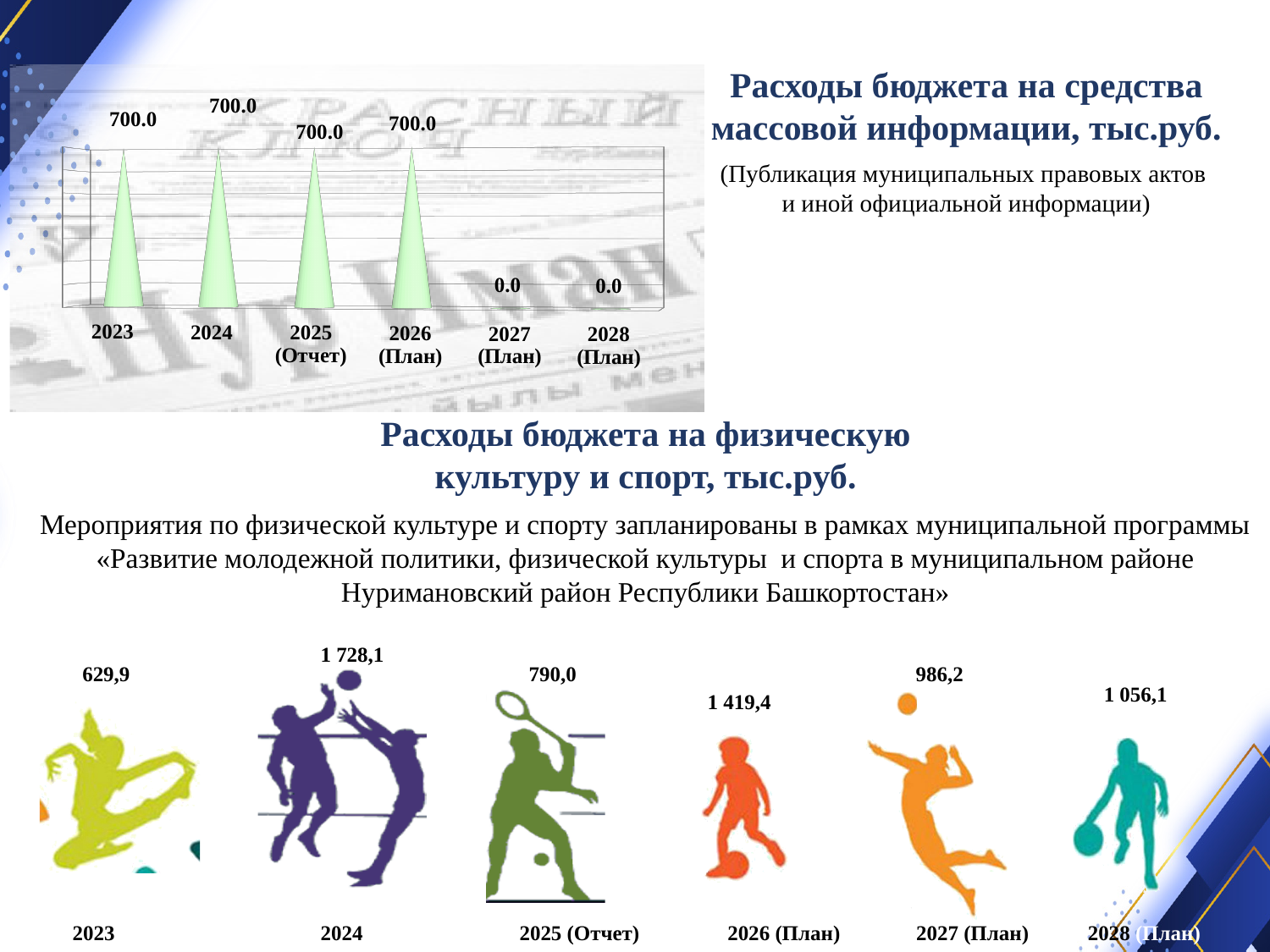
In the chart 'Расходы бюджета на физическую культуру и спорт, тыс.руб.', how many years are shown? 6 In the chart 'Расходы бюджета на средства массовой информации, тыс.руб.', how many years are shown on the x axis? 6 In the chart 'Расходы бюджета на физическую культуру и спорт, тыс.руб.', which year has the lowest value? 2023 In the chart 'Расходы бюджета на средства массовой информации, тыс.руб.', what is the difference between the values for 2026 (План) and 2028 (План)? 700.0 In the chart 'Расходы бюджета на физическую культуру и спорт, тыс.руб.', which is larger, the value for 2026 (План) or the value for 2027 (План)? 2026 (План) In the chart 'Расходы бюджета на физическую культуру и спорт, тыс.руб.', what is the value for 2024? 1 728,1 In the chart 'Расходы бюджета на средства массовой информации, тыс.руб.', which is larger, the value for 2025 (Отчет) or the value for 2027 (План)? 2025 (Отчет) In the chart 'Расходы бюджета на физическую культуру и спорт, тыс.руб.', which year has the highest value? 2024 In the chart 'Расходы бюджета на средства массовой информации, тыс.руб.', what is the value for 2027 (План)? 0.0 In the chart 'Расходы бюджета на средства массовой информации, тыс.руб.', what is the value for 2023? 700.0 In the chart 'Расходы бюджета на средства массовой информации, тыс.руб.', do the values rise, fall or stay the same from 2023 to 2026 (План)? stay the same In the chart 'Расходы бюджета на физическую культуру и спорт, тыс.руб.', what is the value for 2028 (План)? 1 056,1